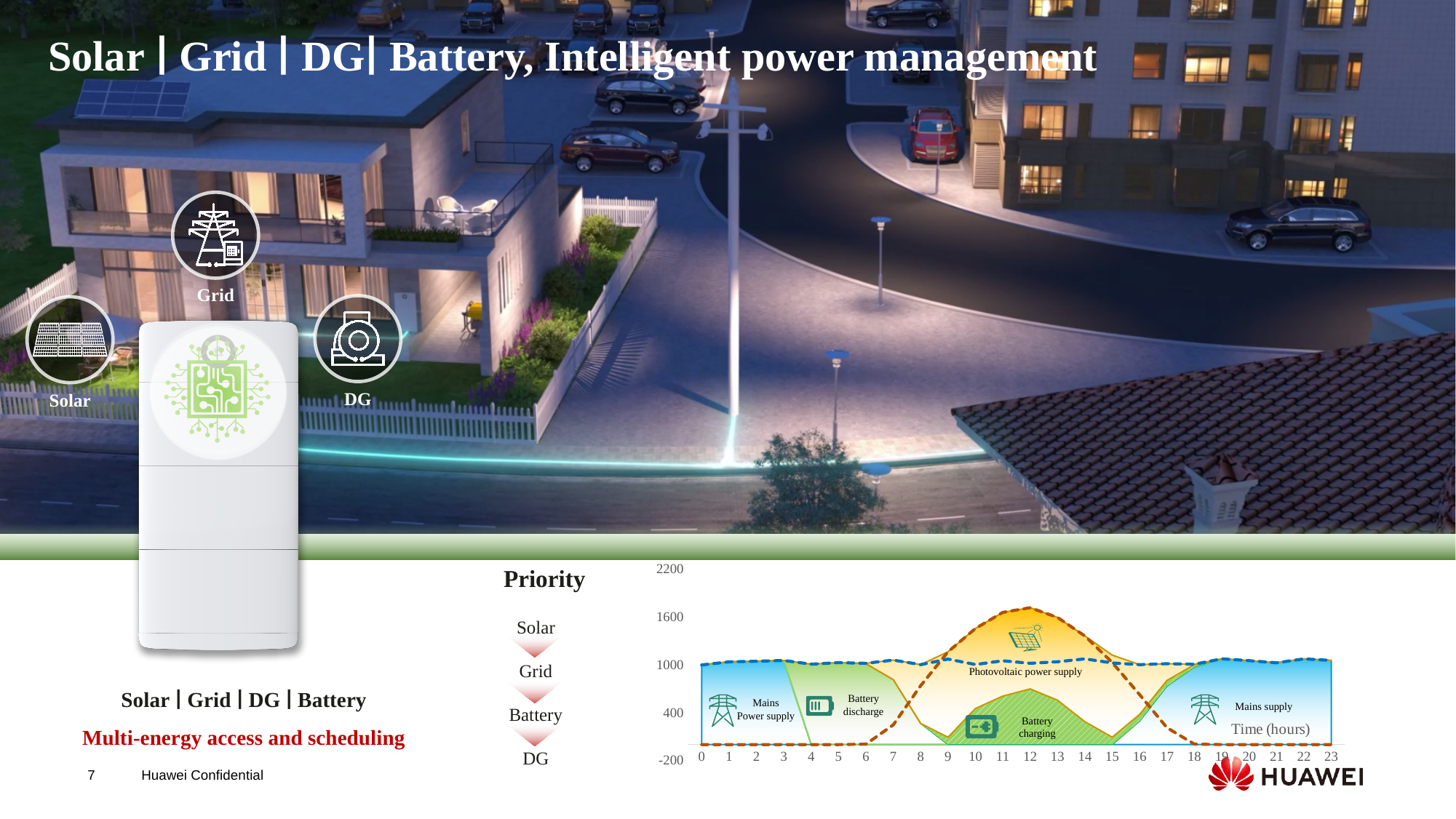
How many hour ticks are shown along the x axis of the chart? 24 What is the highest tick value shown on the y axis of the chart? 2200 What is the label of the x axis of the chart? Time (hours) Is the photovoltaic power supply (orange dashed line) at hour 12 greater or less than 1000? greater At which hour does the photovoltaic power supply (orange dashed line) reach its peak? 12 What kind of chart is shown at the bottom right of the slide? area chart Is the photovoltaic power supply (orange dashed line) at hour 22 greater or less than 400? less Is the blue dashed line at hour 0 greater or less than 400? greater Does the photovoltaic power supply (orange dashed line) rise or fall between hour 6 and hour 12? rise Does the photovoltaic power supply (orange dashed line) rise or fall between hour 12 and hour 18? fall Which supply region is labeled at the top of the chart around midday? Photovoltaic power supply